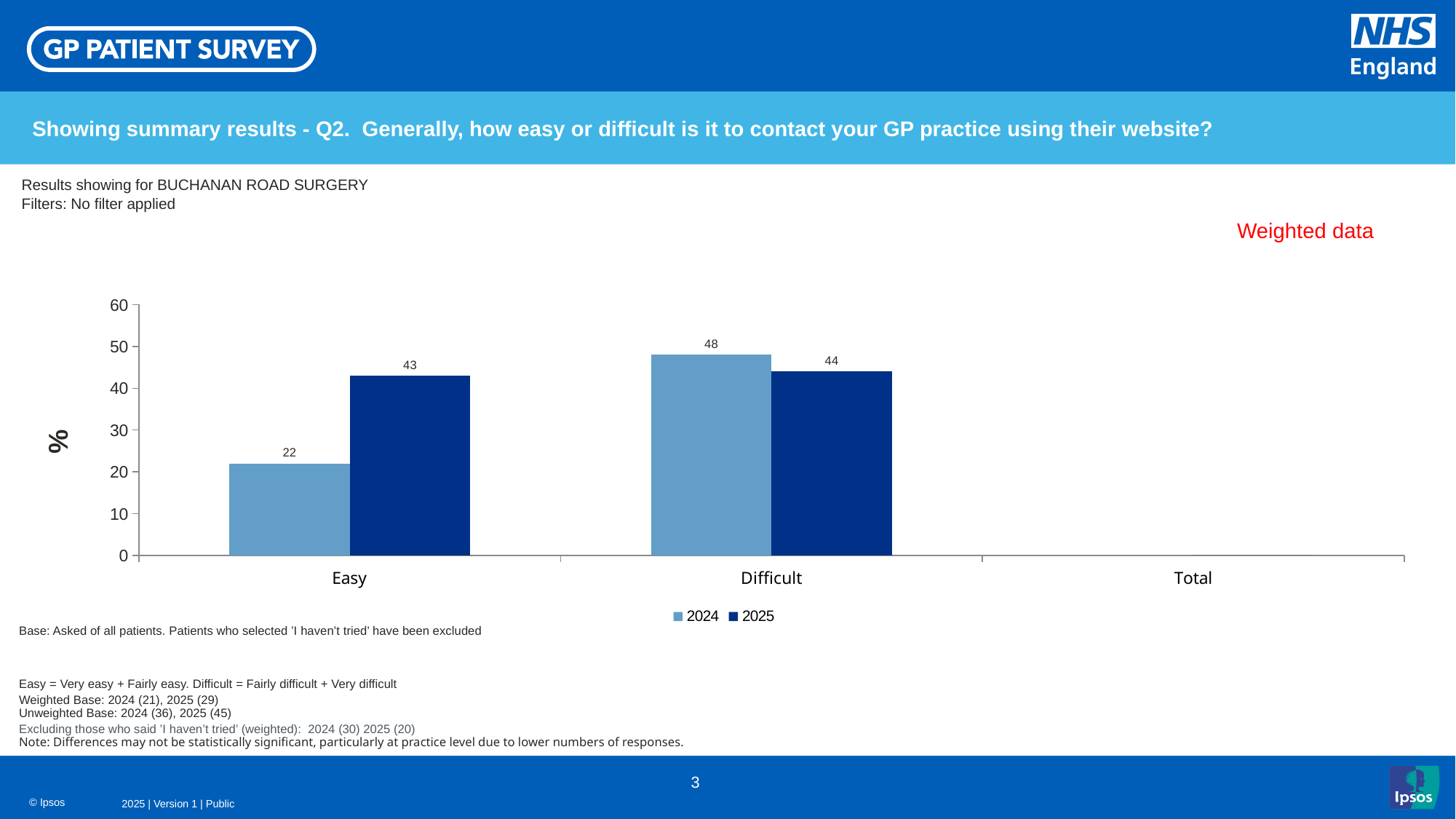
Which is larger: the 2024 value for Easy or the 2024 value for Difficult? Difficult Which category has the lowest value in the 2024 series? Easy What label is shown on the y axis of the chart? % What kind of chart is shown on the slide? Bar chart What is the value for Easy in 2024? 22 How many series does the legend list? 2 What is the value for Easy in 2025? 43 What is the value for Difficult in 2025? 44 What is the value for Difficult in 2024? 48 Which category has the highest value in the 2024 series? Difficult What is the difference between the 2025 and 2024 values for Easy? 21 What is the difference between the 2024 and 2025 values for Difficult? 4